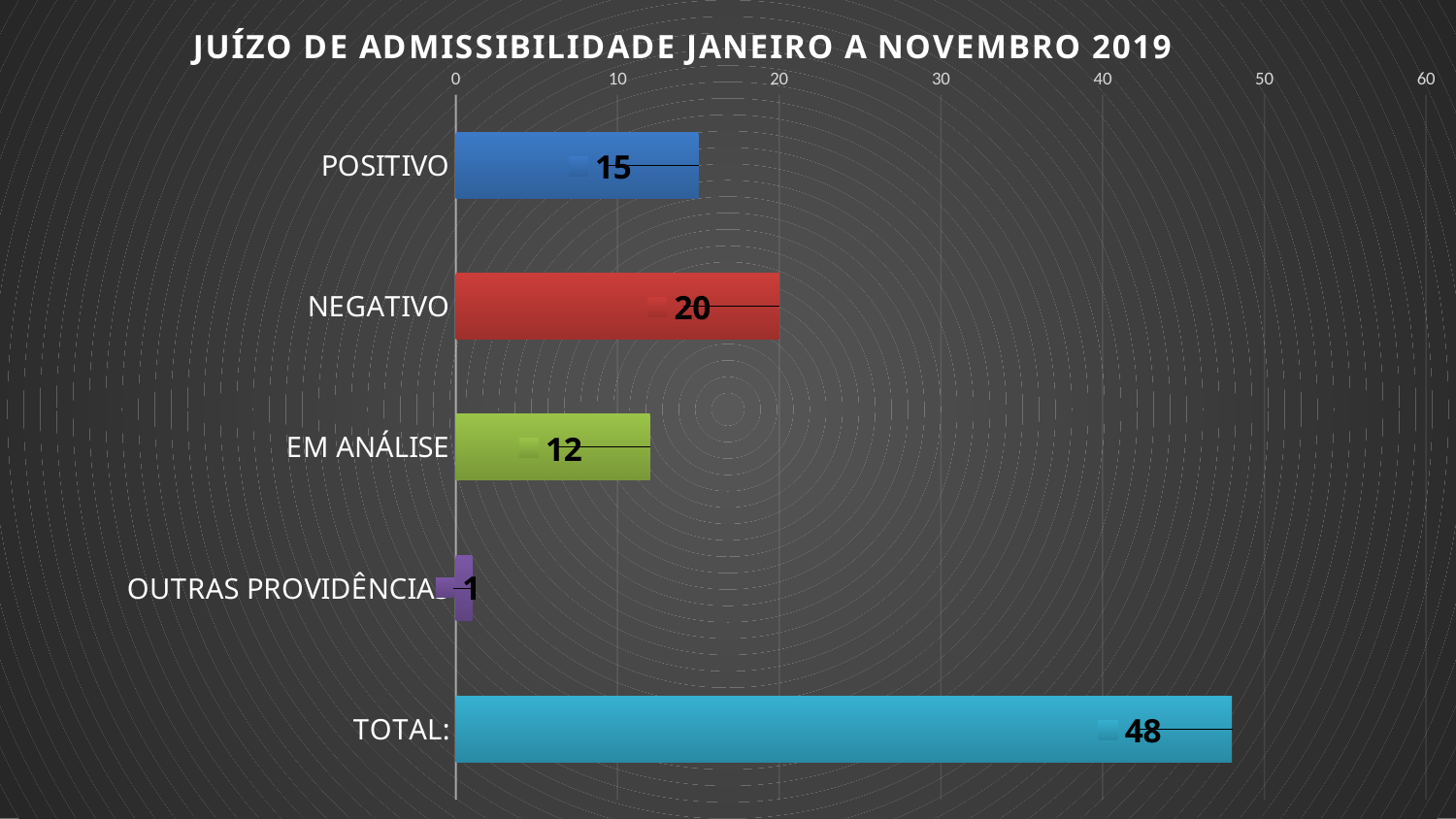
What is the value for OUTRAS PROVIDÊNCIAS? 1 What kind of chart is shown on the slide? Bar chart Which category has the highest value? TOTAL: Which category has the lowest value? OUTRAS PROVIDÊNCIAS How many categories are shown in the chart? 5 What is the value for NEGATIVO? 20 What is the difference between the values for NEGATIVO and POSITIVO? 5 What is the value for EM ANÁLISE? 12 What is the value for TOTAL:? 48 Which is larger, the value for POSITIVO or the value for EM ANÁLISE? POSITIVO What is the value for POSITIVO? 15 What is the title of the chart? JUÍZO DE ADMISSIBILIDADE JANEIRO A NOVEMBRO 2019